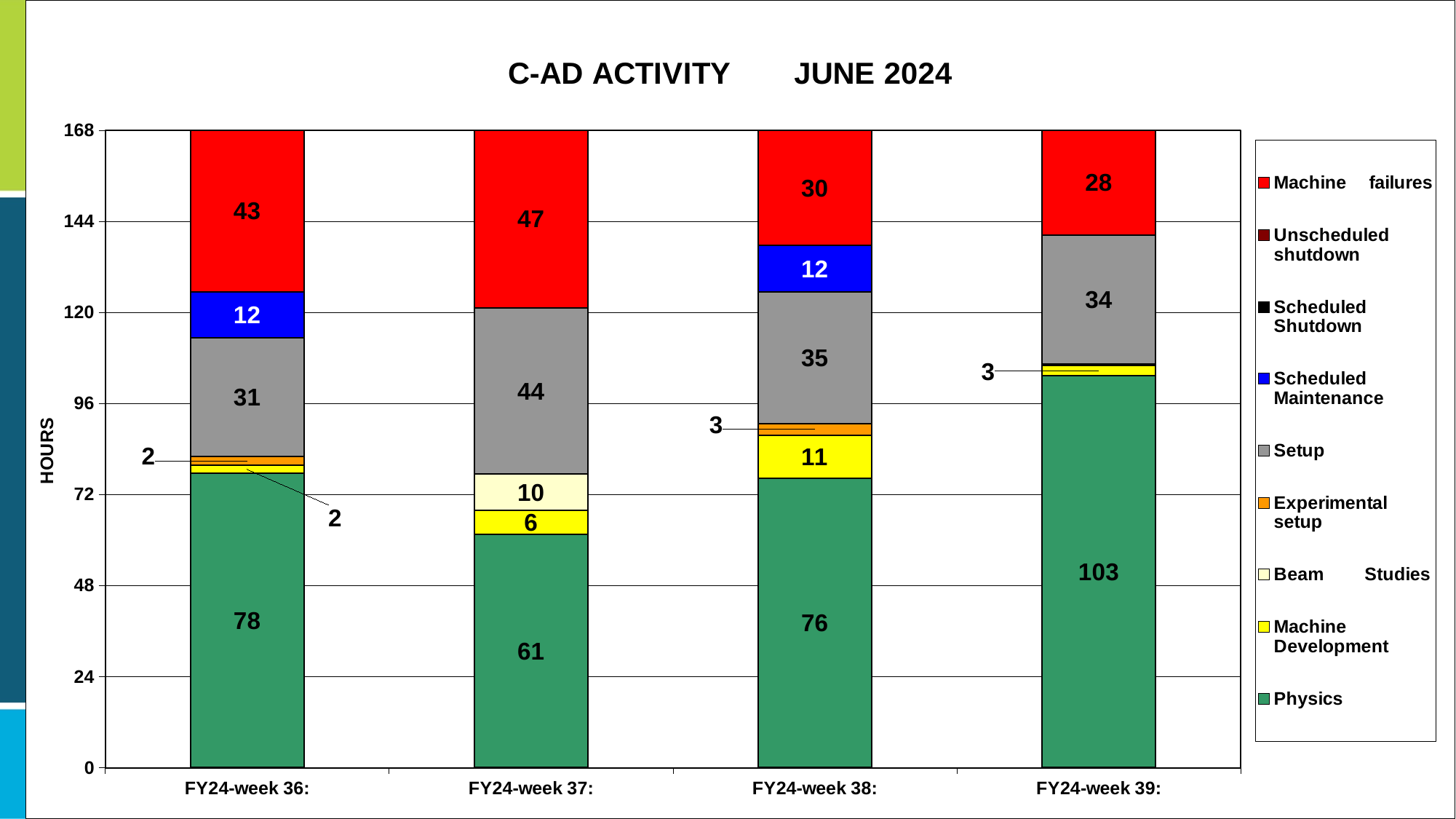
How many series does the legend list? 9 What is the Machine failures value for FY24-week 37? 47 What kind of chart is shown on the slide? Stacked bar chart Which week has the lowest Machine failures hours? FY24-week 39 How many hours of Physics are shown for FY24-week 39? 103 Which week has more Physics hours, FY24-week 36 or FY24-week 38? FY24-week 36 What is the Scheduled Maintenance value for FY24-week 38? 12 Which week has the highest Physics hours? FY24-week 39 How many weeks (categories) are shown on the x axis? 4 What is the difference in Setup hours between FY24-week 37 and FY24-week 36? 13 What is the label on the vertical axis? HOURS What is the Beam Studies value for FY24-week 37? 10